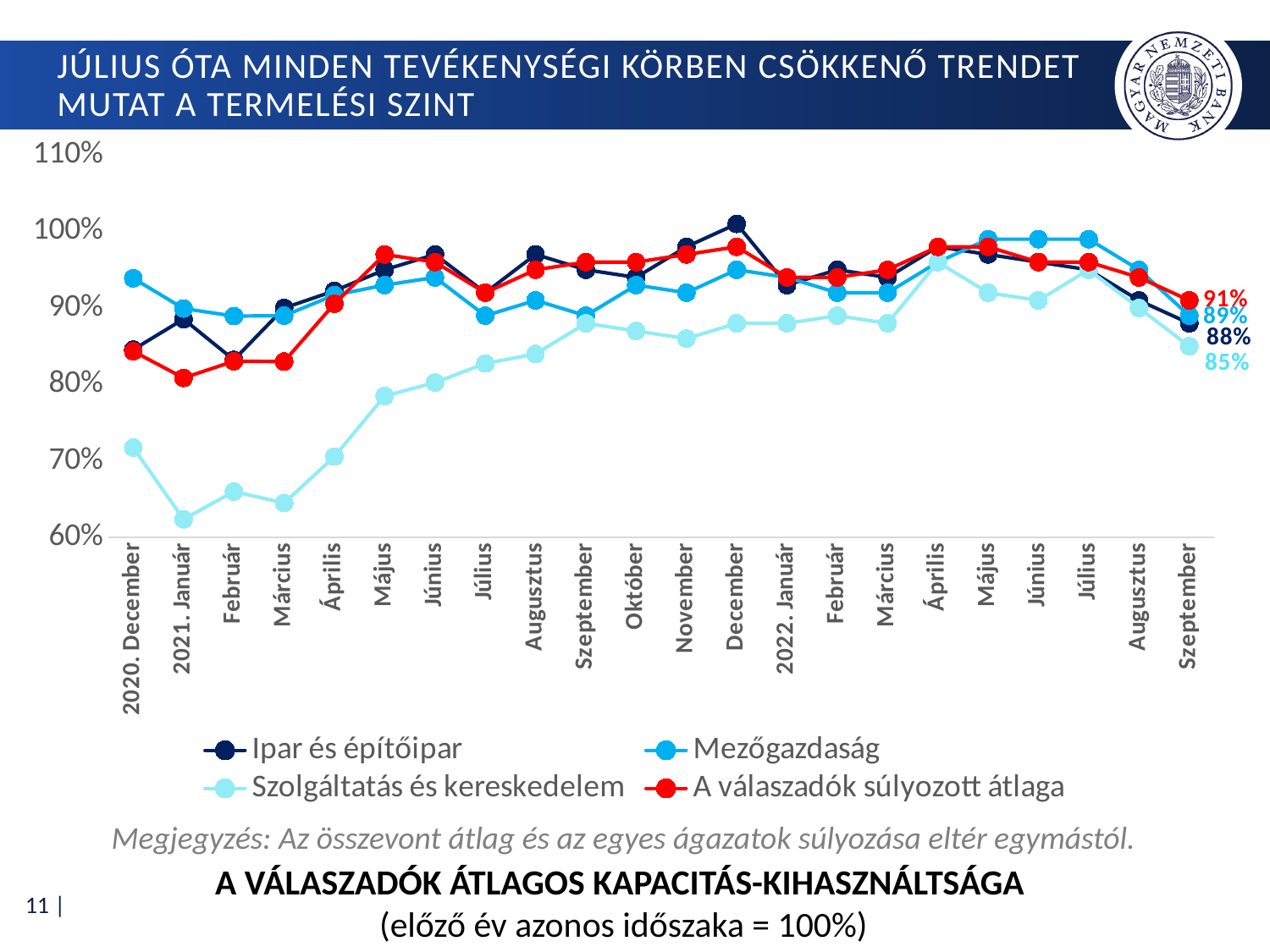
How many series does the legend list? 4 What is the value of 'A válaszadók súlyozott átlaga' in Szeptember 2022? 91% What is the difference between 'A válaszadók súlyozott átlaga' and 'Szolgáltatás és kereskedelem' in Szeptember 2022? 6 percentage points Is the value for 'Szolgáltatás és kereskedelem' in 2021. Január greater or less than 70%? less What is the value of 'Ipar és építőipar' in Szeptember 2022? 88% What kind of chart is shown on the slide? line chart Which series has the lowest value in Szeptember 2022? Szolgáltatás és kereskedelem What is the value of 'Mezőgazdaság' in Szeptember 2022? 89% What is the value of 'Szolgáltatás és kereskedelem' in Szeptember 2022? 85% What is the title of the chart? A válaszadók átlagos kapacitás-kihasználtsága (előző év azonos időszaka = 100%) Does the 'Szolgáltatás és kereskedelem' series rise or fall between 2021. Január and Szeptember 2021? rise How many time points are plotted along the x axis? 22